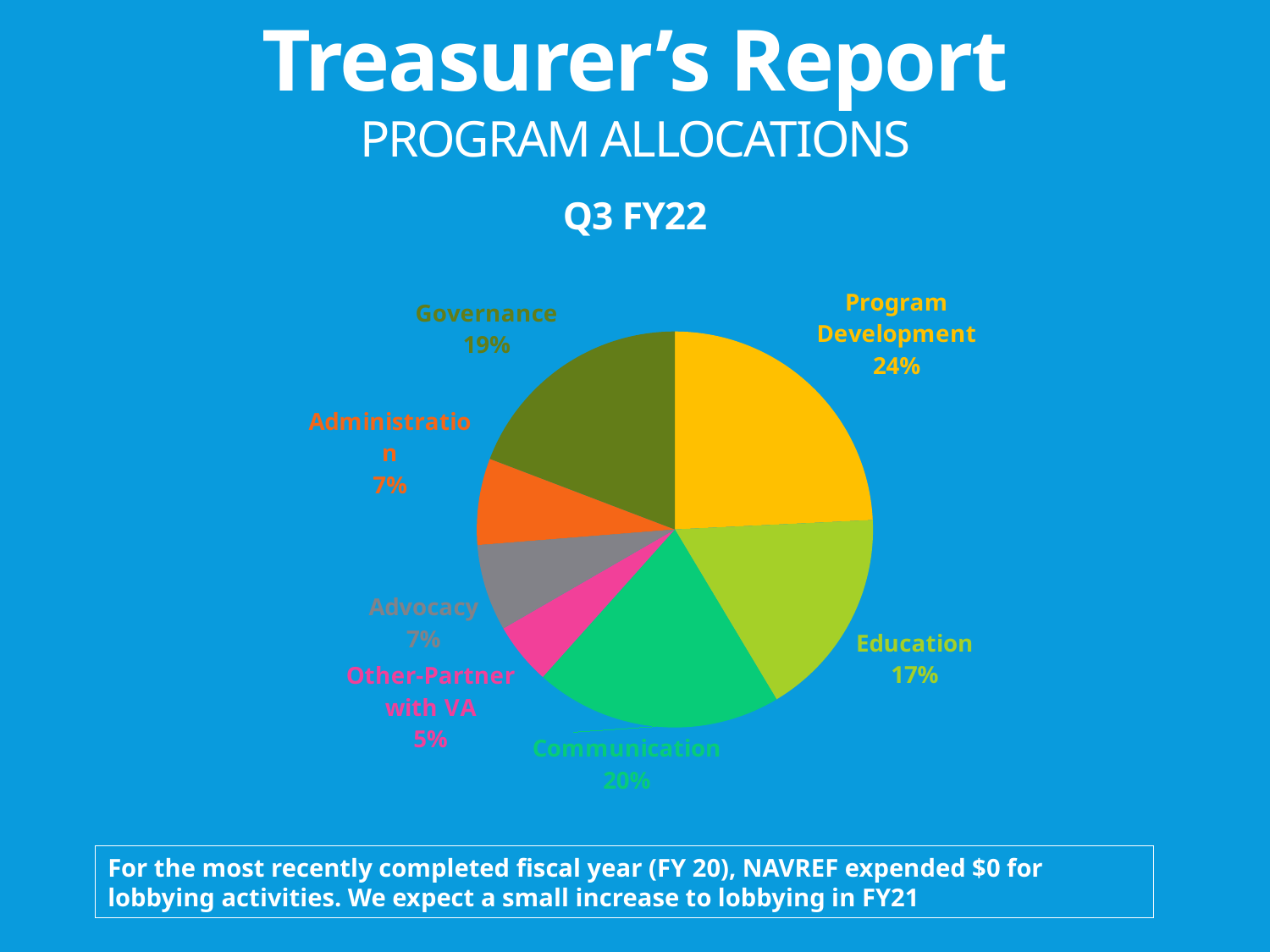
Which is larger, Communication or Governance? Communication What is the chart's title? Q3 FY22 What share of the pie does Program Development take? 24% Which category has the largest slice of the pie? Program Development What is the difference in percentage points between Program Development and Education? 7 What percentage is shown for Governance? 19% How many categories are shown in the pie chart? 7 What percentage is shown for Other-Partner with VA? 5% What percentage is shown for Communication? 20% What percentage is shown for Education? 17% Which category has the smallest slice of the pie? Other-Partner with VA What kind of chart is shown on the slide? Pie chart